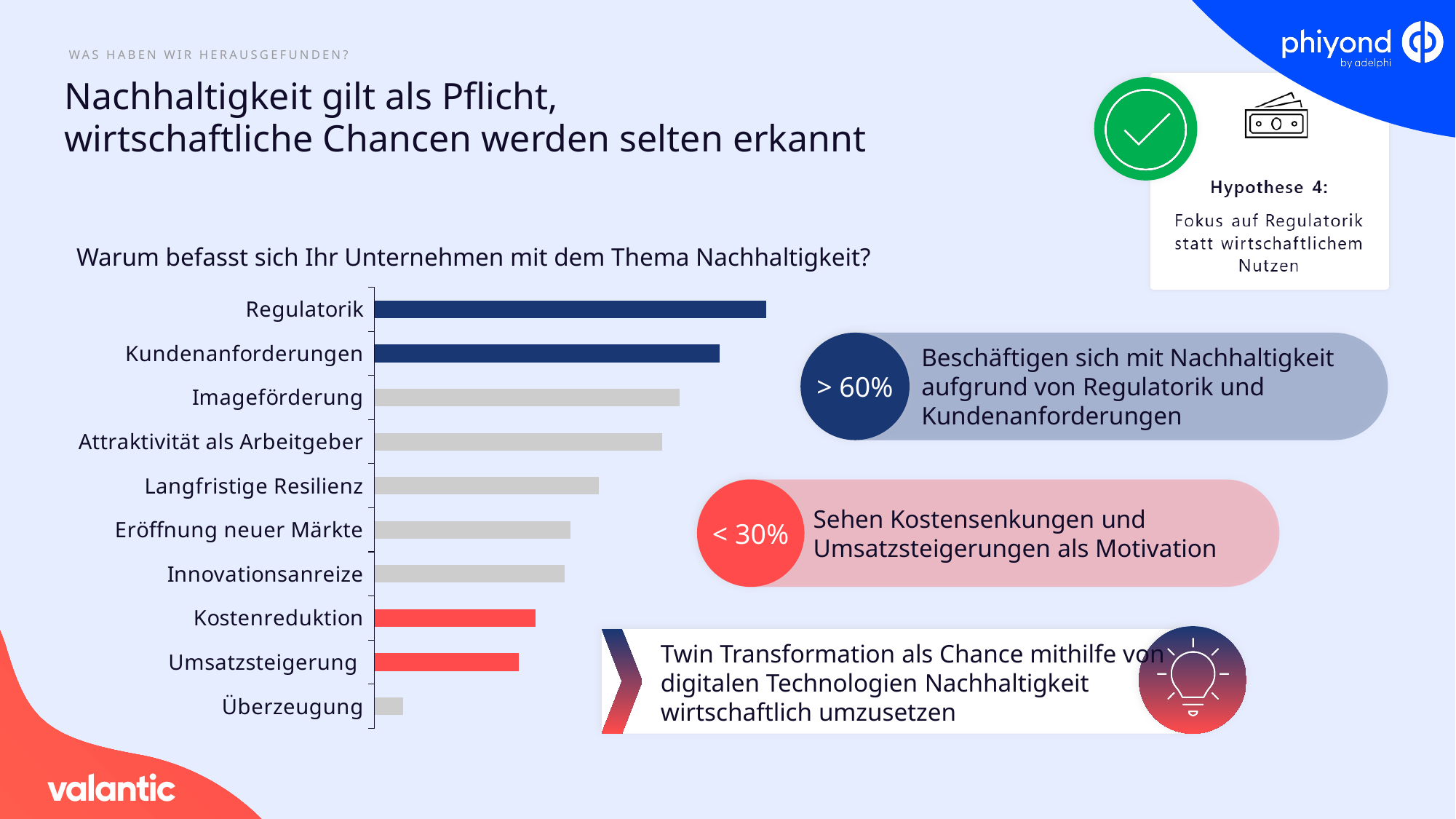
What kind of chart is shown on the slide? bar chart Which category has the longest bar in the chart? Regulatorik Which category has the shortest bar in the chart? Überzeugung What question is the bar chart titled with? Warum befasst sich Ihr Unternehmen mit dem Thema Nachhaltigkeit? Which has the larger value, Imageförderung or Kostenreduktion? Imageförderung Do the bars get longer or shorter going from the top category to the bottom category? shorter Which two categories are shown with red bars? Kostenreduktion and Umsatzsteigerung Which has the larger value, Kundenanforderungen or Langfristige Resilienz? Kundenanforderungen How many categories does the bar chart show? 10 Which has the larger value, Innovationsanreize or Überzeugung? Innovationsanreize